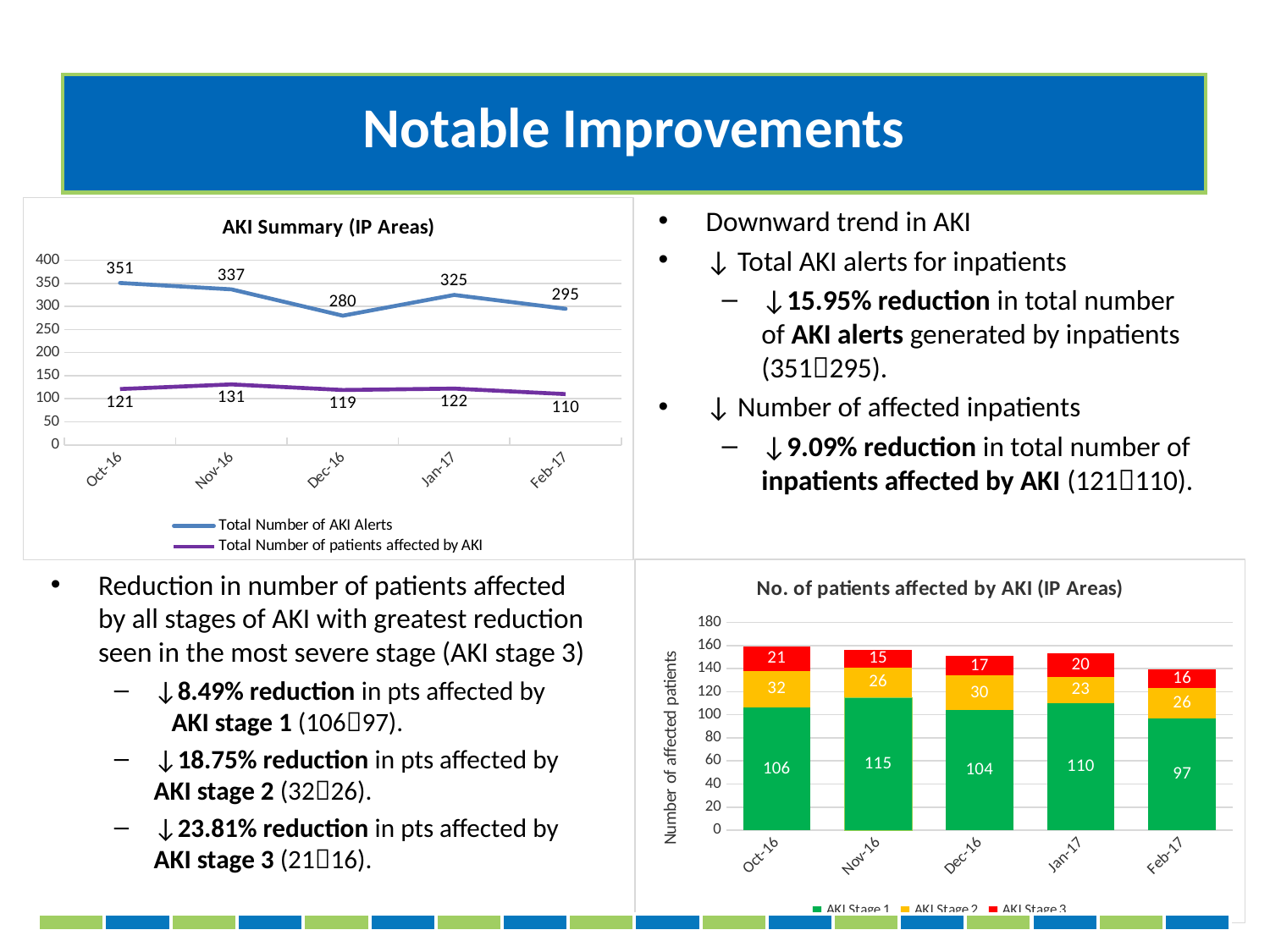
What kind of chart is 'AKI Summary (IP Areas)'? Line chart In the 'AKI Summary (IP Areas)' chart, what is the Total Number of patients affected by AKI for Nov-16? 131 In the 'AKI Summary (IP Areas)' chart, what is the difference between the Total Number of AKI Alerts in Oct-16 and Feb-17? 56 In the 'No. of patients affected by AKI (IP Areas)' chart, what is the total of the stacked bar for Oct-16? 159 In the 'AKI Summary (IP Areas)' chart, what is the Total Number of AKI Alerts for Dec-16? 280 How many months are shown on the x axis of the 'No. of patients affected by AKI (IP Areas)' chart? 5 In the 'AKI Summary (IP Areas)' chart, which month has the lowest Total Number of patients affected by AKI? Feb-17 In the 'No. of patients affected by AKI (IP Areas)' chart, which month has the highest AKI Stage 1 value? Nov-16 In the 'AKI Summary (IP Areas)' chart, which month has the highest Total Number of AKI Alerts? Oct-16 In the 'No. of patients affected by AKI (IP Areas)' chart, what is the AKI Stage 2 value for Dec-16? 30 How many series does the legend of the 'AKI Summary (IP Areas)' chart list? 2 In the 'No. of patients affected by AKI (IP Areas)' chart, is the AKI Stage 3 value larger for Oct-16 or Nov-16? Oct-16